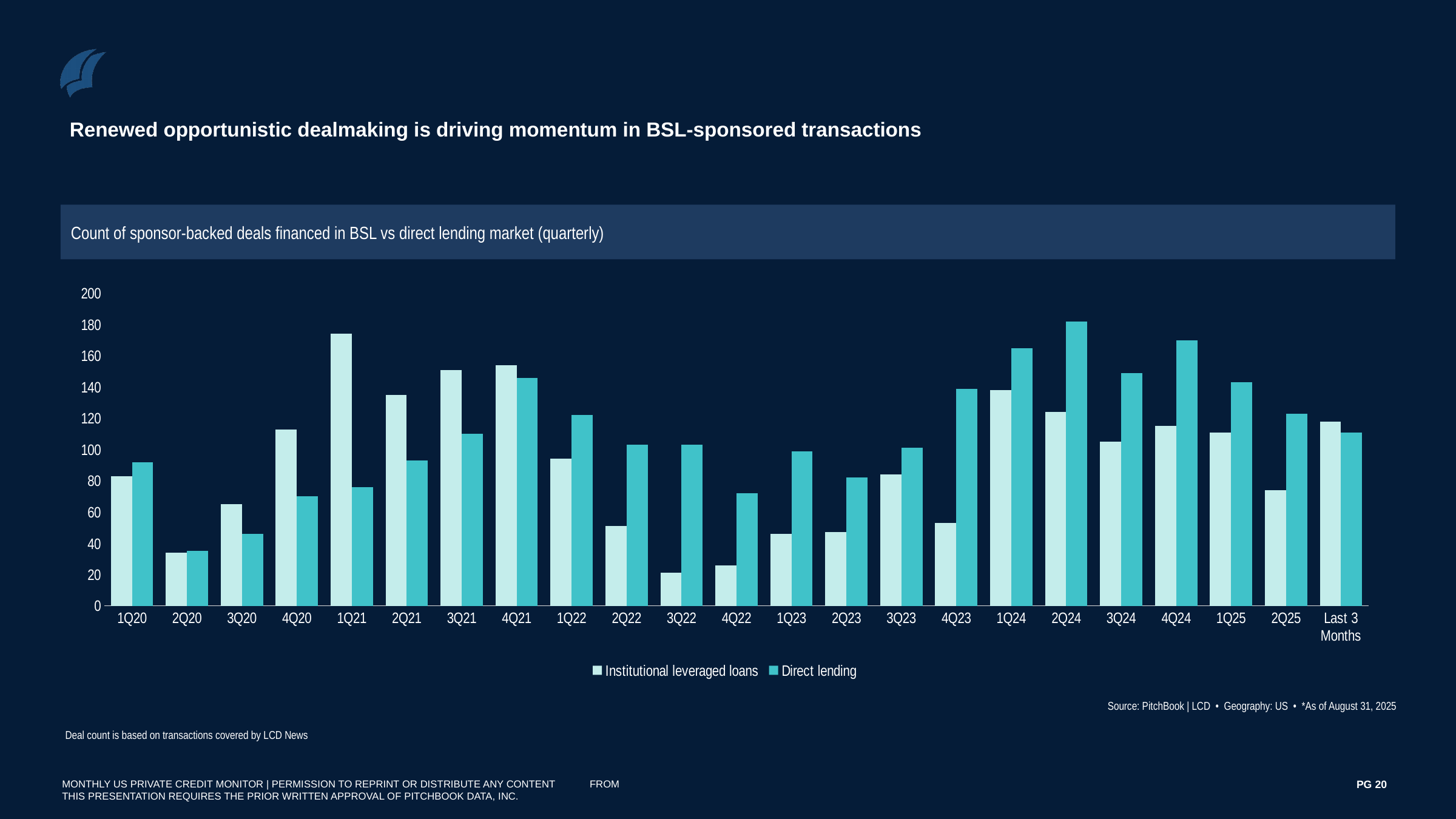
How many series does the legend list? 2 What is the title of the chart? Count of sponsor-backed deals financed in BSL vs direct lending market (quarterly) In which quarter is the Institutional leveraged loans value highest? 1Q21 In which quarter is the Direct lending value highest? 2Q24 Is the Institutional leveraged loans value for 3Q22 greater or less than 40? less In 4Q23, which is larger: Institutional leveraged loans or Direct lending? Direct lending Is the Institutional leveraged loans value for 1Q21 greater or less than 160? greater How many categories are shown on the x axis? 23 Is the Direct lending value for 4Q23 greater or less than 120? greater In which quarter is the Institutional leveraged loans value lowest? 3Q22 In which quarter is the Direct lending value lowest? 2Q20 What kind of chart is shown on the slide? bar chart